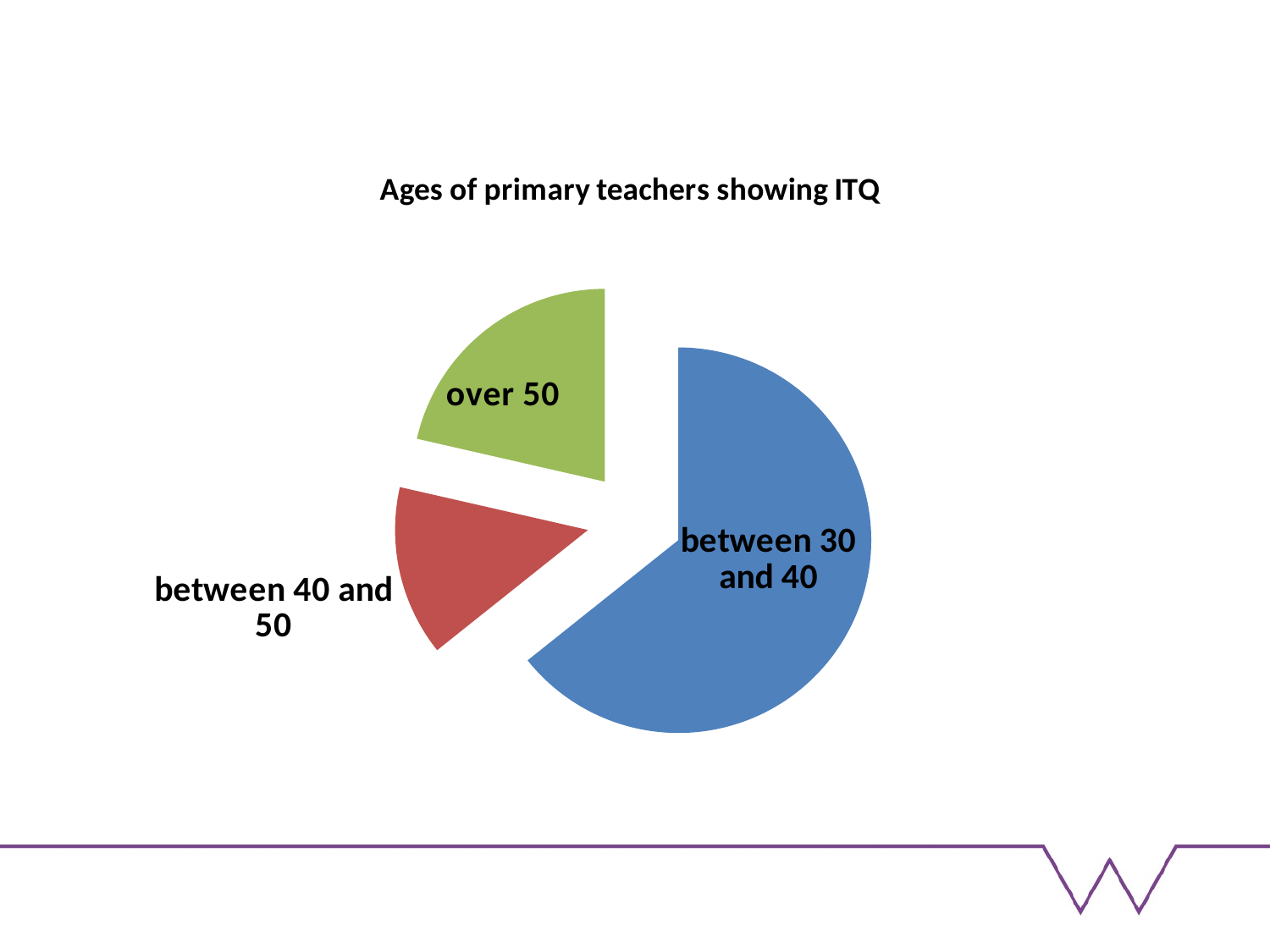
How many slices does the pie chart have? 3 Is the 'between 30 and 40' slice greater or less than half of the pie? greater Which age group has the largest slice of the pie? between 30 and 40 Which slice is larger: 'between 30 and 40' or 'over 50'? between 30 and 40 Is the 'over 50' slice greater or less than half of the pie? less Which slice is larger: 'over 50' or 'between 40 and 50'? over 50 What kind of chart is shown on the slide? pie chart Which age group has the smallest slice of the pie? between 40 and 50 What colour is the 'between 30 and 40' slice? blue What is the title of the chart? Ages of primary teachers showing ITQ